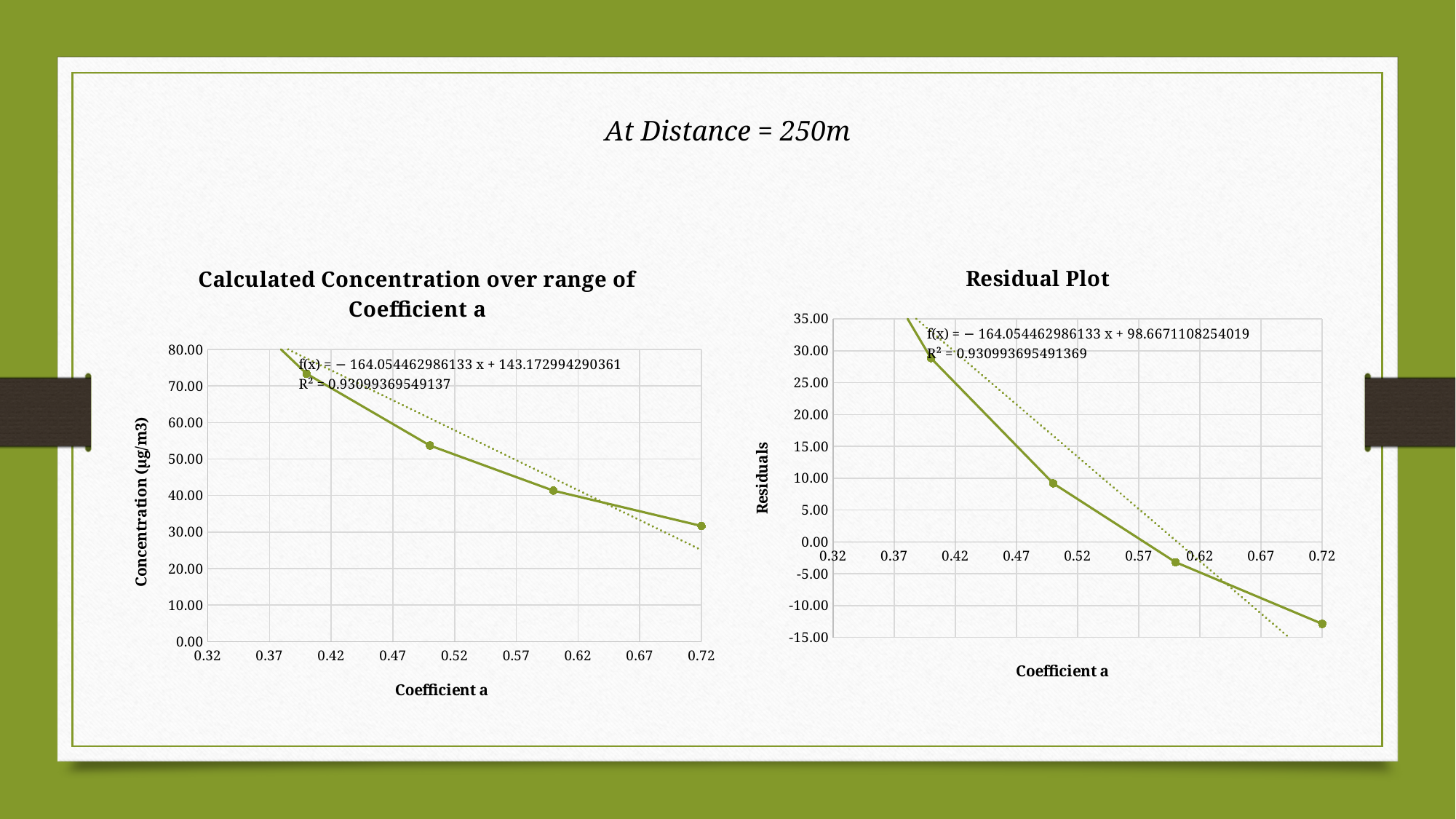
On the "Calculated Concentration over range of Coefficient a" chart, is the concentration at the leftmost point (Coefficient a = 0.40) greater or less than 70.00? greater On the "Residual Plot" chart, is the residual at Coefficient a = 0.50 greater or less than 5.00? greater On the "Calculated Concentration over range of Coefficient a" chart, do the concentration values rise or fall as Coefficient a increases? fall What is the R² value shown on the "Residual Plot" chart? 0.930993695491369 On the "Residual Plot" chart, do the residuals rise or fall as Coefficient a increases? fall What kind of chart is the "Calculated Concentration over range of Coefficient a" chart? line chart On the "Residual Plot" chart, is the residual at Coefficient a = 0.72 greater or less than -10.00? less On the "Calculated Concentration over range of Coefficient a" chart, which is larger: the concentration at Coefficient a = 0.50 or at 0.60? 0.50